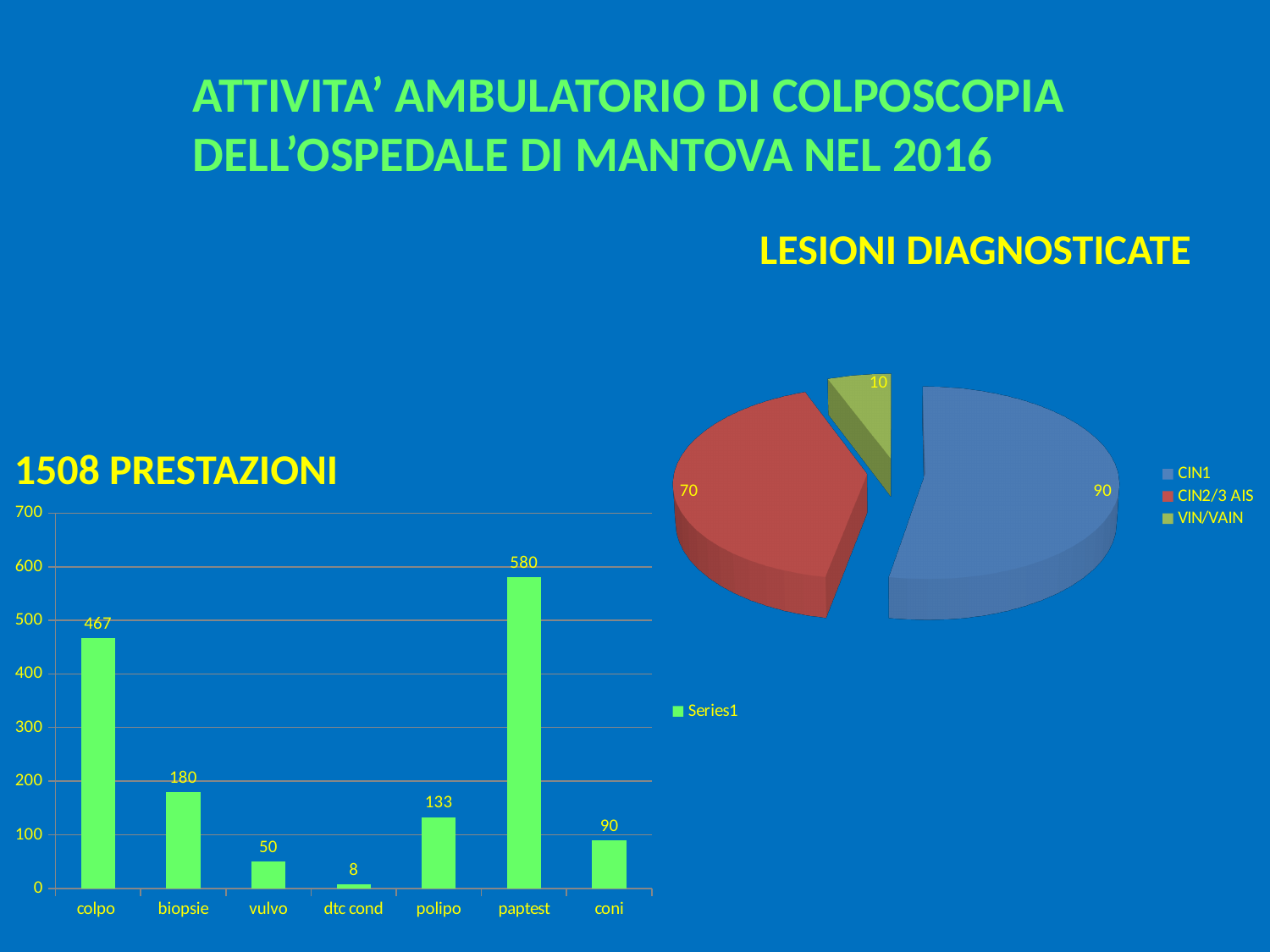
In the bar chart titled 1508 PRESTAZIONI, how many categories are shown on the x axis? 7 In the bar chart titled 1508 PRESTAZIONI, which category has the lowest value? dtc cond In the pie chart titled LESIONI DIAGNOSTICATE, what is the value for CIN2/3 AIS? 70 In the bar chart titled 1508 PRESTAZIONI, which category has the highest value? paptest What kind of chart is the one titled 1508 PRESTAZIONI? bar chart In the bar chart titled 1508 PRESTAZIONI, which is larger, the value for coni or the value for vulvo? coni In the bar chart titled 1508 PRESTAZIONI, what is the value for paptest? 580 In the pie chart titled LESIONI DIAGNOSTICATE, which category has the largest slice? CIN1 In the pie chart titled LESIONI DIAGNOSTICATE, what is the difference between the values for CIN1 and VIN/VAIN? 80 In the bar chart titled 1508 PRESTAZIONI, what is the difference between the values for colpo and biopsie? 287 In the bar chart titled 1508 PRESTAZIONI, what is the value for polipo? 133 How many entries does the legend of the pie chart titled LESIONI DIAGNOSTICATE list? 3